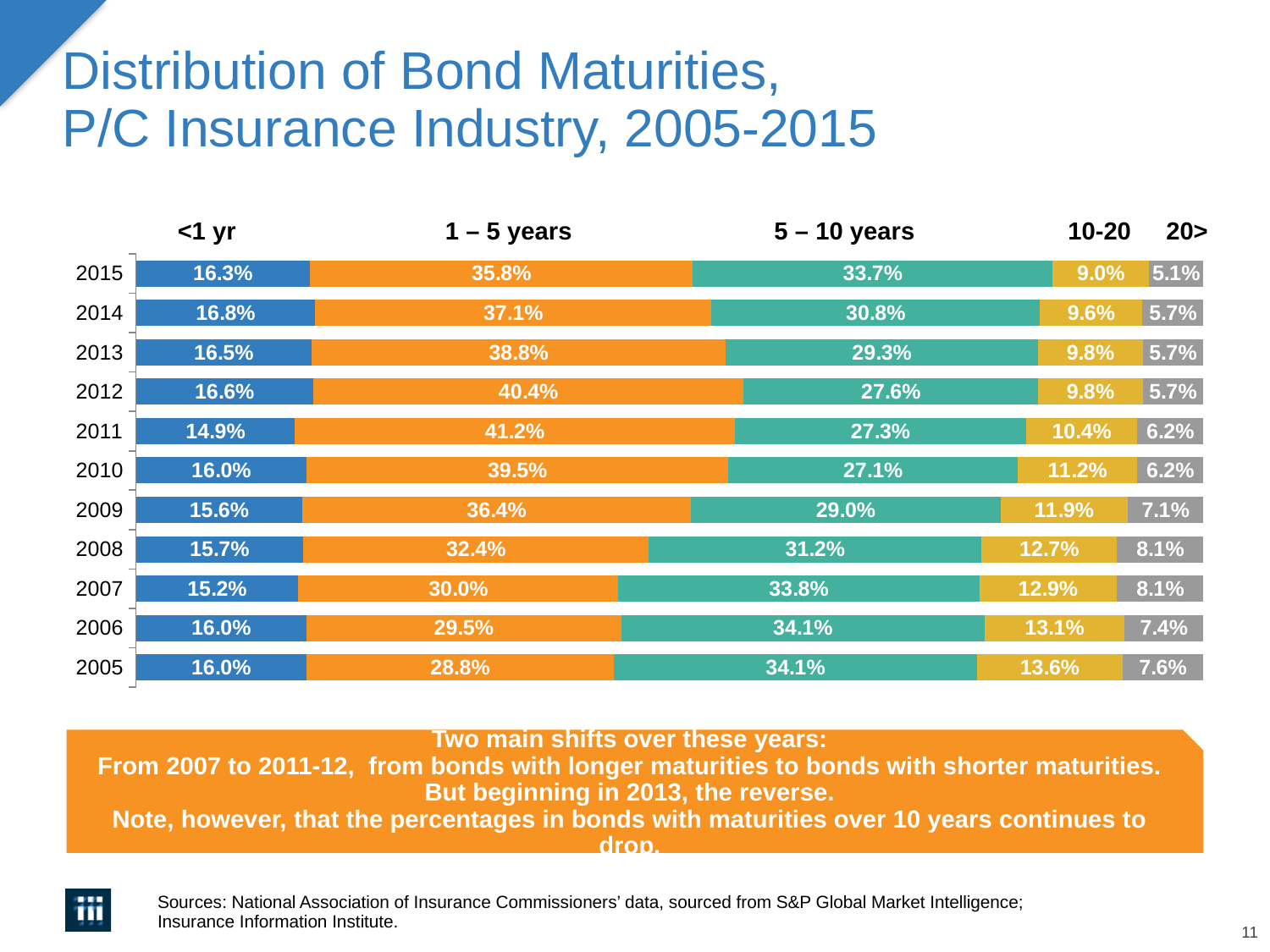
How many years are shown in the chart? 11 What share of bonds had maturities of 10-20 years in 2010? 11.2% How many maturity categories does the chart show? 5 In which year was the <1 yr share the lowest? 2011 In which year was the 1 – 5 years share the highest? 2011 In which year was the 10-20 share the highest? 2005 What share of bonds had maturities of 5 – 10 years in 2005? 34.1% By how many percentage points did the 1 – 5 years share in 2015 exceed that in 2005? 7.0 percentage points What kind of chart is shown on the slide? Stacked bar chart In 2008, which was larger: the 1 – 5 years share or the 5 – 10 years share? 1 – 5 years What share of bonds had maturities of 1 – 5 years in 2015? 35.8% Did the 10-20 share rise or fall from 2005 to 2015? Fall